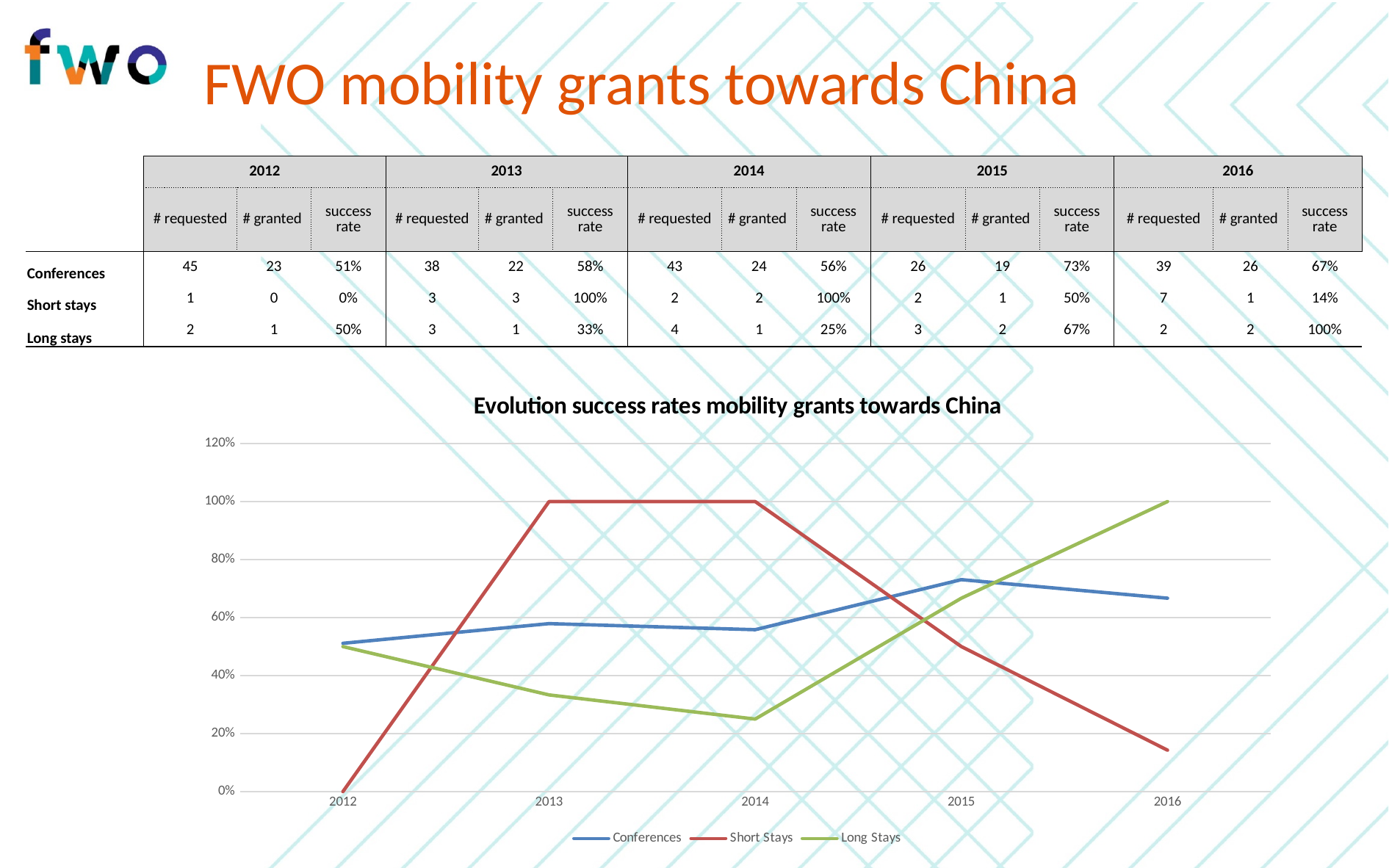
What type of chart is shown on the slide? line chart How many years are shown on the x axis of the chart? 5 What is the success rate for Short Stays in 2012? 0% What is the success rate for Short Stays in 2013? 100% Is the Short Stays success rate in 2016 greater or less than 20%? less Which series has the higher success rate in 2014, Conferences or Long Stays? Conferences What is the success rate for Long Stays in 2016? 100% What is the success rate for Conferences in 2015? 73% In which year is the Long Stays success rate lowest? 2014 What is the title of the chart? Evolution success rates mobility grants towards China In which year is the Conferences success rate highest? 2015 How many series does the chart legend list? 3